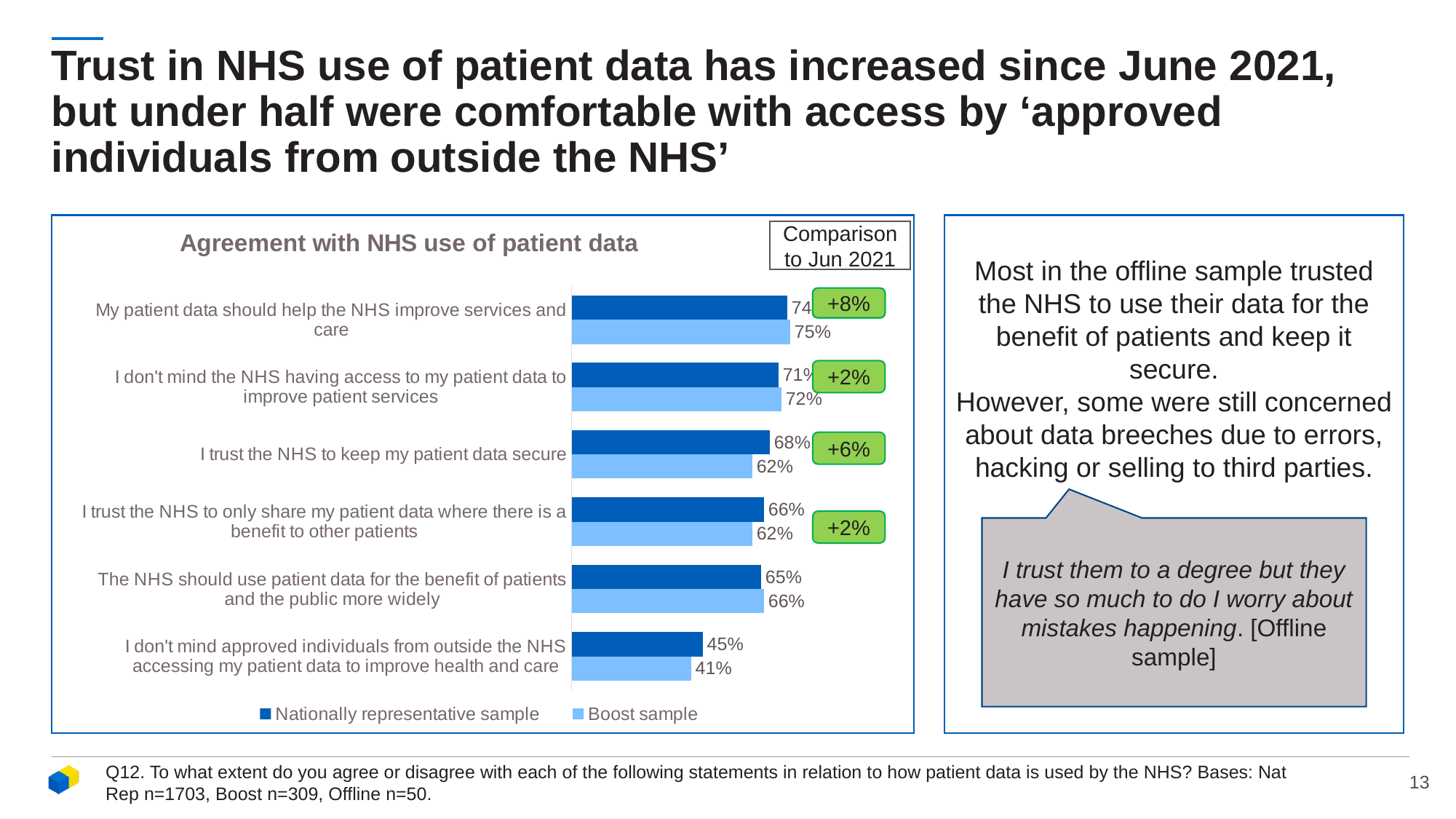
Which statement has the lowest Nationally representative sample value? I don't mind approved individuals from outside the NHS accessing my patient data to improve health and care What is the difference between the Nationally representative sample and Boost sample values for 'I trust the NHS to keep my patient data secure'? 6% For 'I don't mind approved individuals from outside the NHS accessing my patient data to improve health and care', which is larger: the Nationally representative sample value or the Boost sample value? Nationally representative sample Which colour represents the Boost sample in the chart? Light blue Which statement has the highest Boost sample value? My patient data should help the NHS improve services and care How many statements (categories) are plotted in the 'Agreement with NHS use of patient data' chart? 6 What is the Nationally representative sample value for 'I trust the NHS to keep my patient data secure'? 68% What is the Boost sample value for 'My patient data should help the NHS improve services and care'? 75% How many series does the legend of the 'Agreement with NHS use of patient data' chart list? 2 What kind of chart is shown under the title 'Agreement with NHS use of patient data'? Bar chart What is the Boost sample value for 'I don't mind approved individuals from outside the NHS accessing my patient data to improve health and care'? 41% What is the 'Comparison to Jun 2021' change shown for 'My patient data should help the NHS improve services and care'? +8%